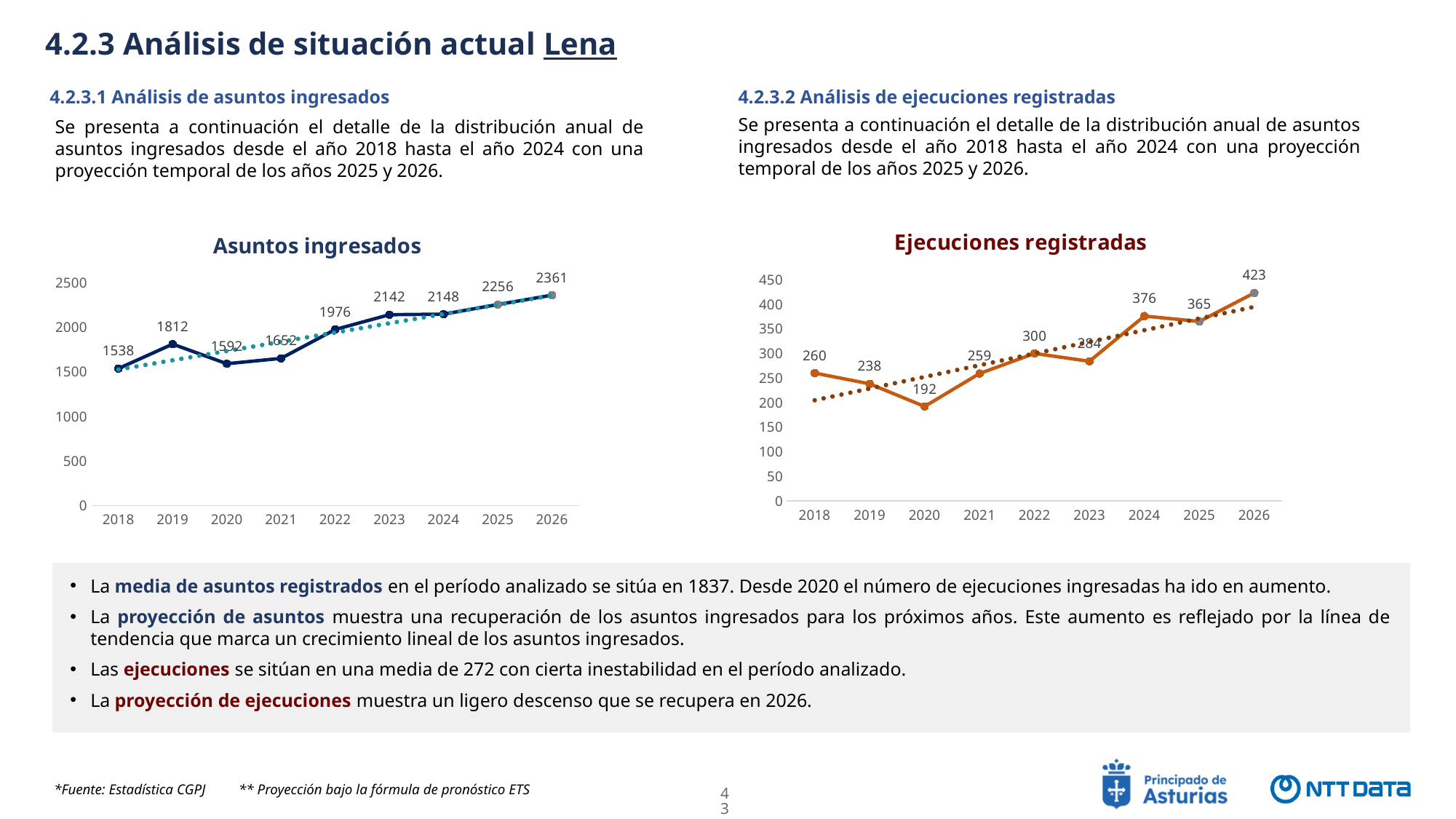
In the 'Ejecuciones registradas' chart, which year has the highest value? 2026 In the 'Ejecuciones registradas' chart, what is the value for 2020? 192 In the 'Ejecuciones registradas' chart, what is the value for 2024? 376 What kind of chart is 'Asuntos ingresados'? Line chart In the 'Asuntos ingresados' chart, what is the difference between the values for 2026 and 2024? 213 In the 'Ejecuciones registradas' chart, what is the difference between the values for 2022 and 2021? 41 In the 'Ejecuciones registradas' chart, how many years are shown on the x axis? 9 In the 'Asuntos ingresados' chart, what is the value for 2018? 1538 In the 'Asuntos ingresados' chart, which is larger, the value for 2019 or the value for 2020? 2019 In the 'Asuntos ingresados' chart, what is the value for 2023? 2142 In the 'Ejecuciones registradas' chart, do the values rise or fall from 2020 to 2022? Rise In the 'Asuntos ingresados' chart, which year has the lowest value? 2018